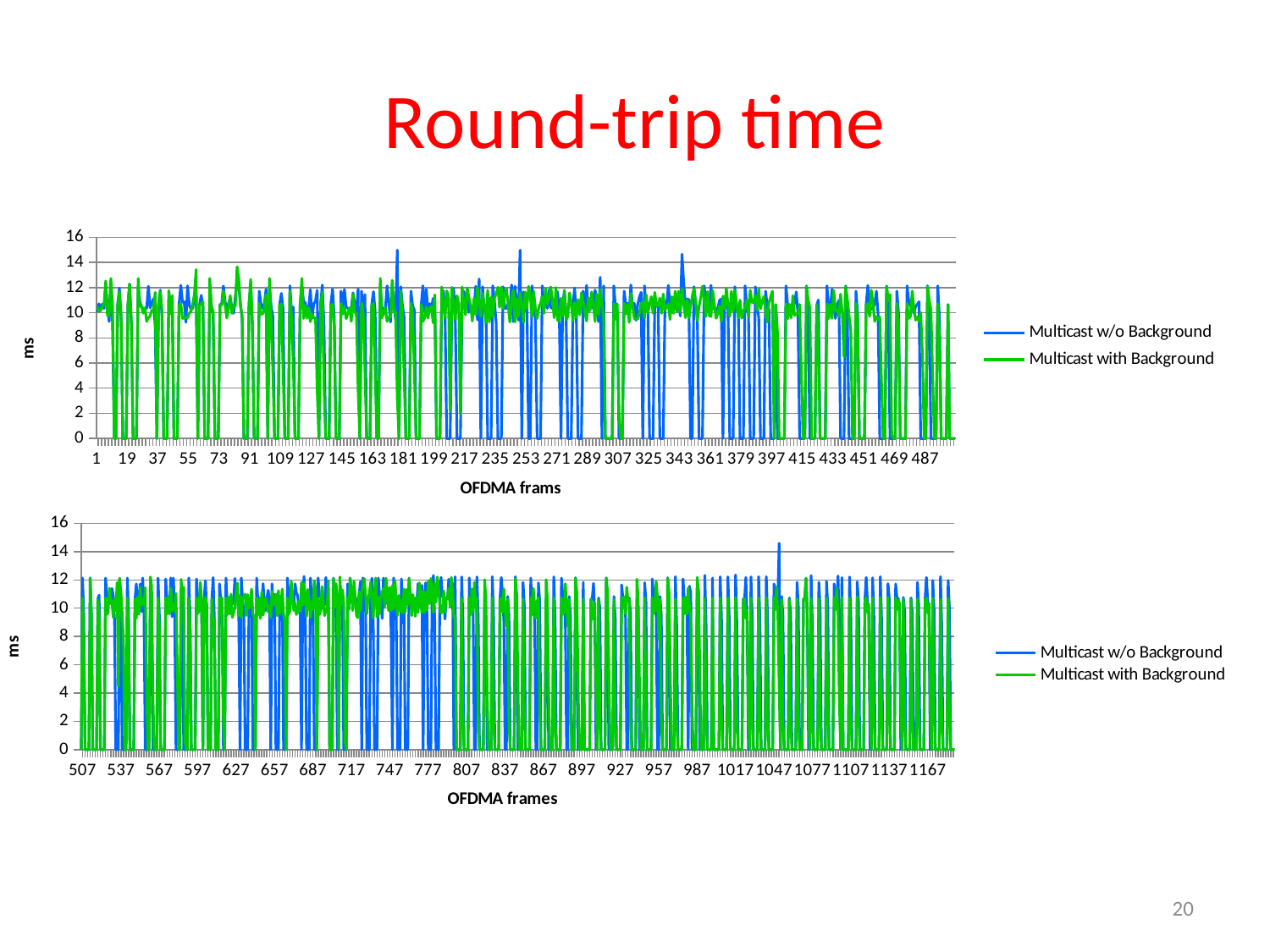
How many series does the legend of the top chart list? 2 What is the first x-axis tick label on the bottom chart? 507 In the bottom chart, which series is drawn in blue? Multicast w/o Background In the bottom chart, is the highest peak of the Multicast w/o Background series greater or less than 12? greater What kind of chart is the bottom chart on the slide? line chart What is the maximum value shown on the vertical axis of the top chart? 16 How many series does the legend of the bottom chart list? 2 What kind of chart is the top chart on the slide? line chart In the top chart, is the highest peak of the Multicast w/o Background series greater or less than 14? greater What is the last x-axis tick label on the bottom chart? 1167 What is the title of the slide containing the two charts? Round-trip time In the top chart, which series is drawn in green? Multicast with Background